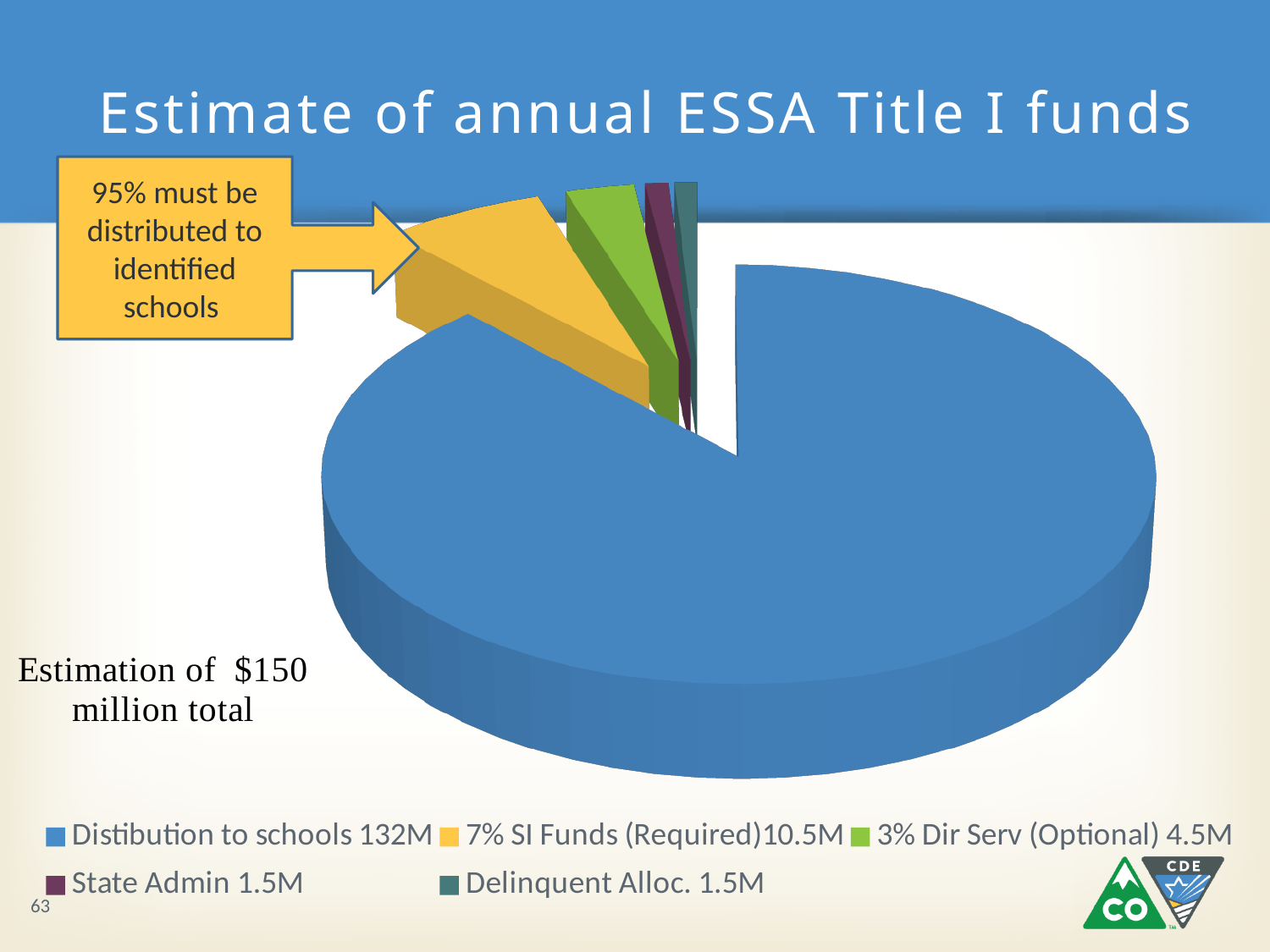
What is the difference between Distribution to schools (132M) and 7% SI Funds (Required) (10.5M)? 121.5M What is the title of the chart? Estimate of annual ESSA Title I funds What kind of chart is shown on the slide? pie chart How many slices does the pie chart have? 5 What value is given for State Admin? 1.5M What value is given for 7% SI Funds (Required)? 10.5M What value is given for Distribution to schools in the legend? 132M Which colour represents Distribution to schools in the legend? blue Which is larger, 7% SI Funds (Required) or 3% Dir Serv (Optional)? 7% SI Funds (Required) What value is given for 3% Dir Serv (Optional)? 4.5M Which category has the largest slice of the pie? Distribution to schools What is the estimated total amount represented by the pie chart? $150 million